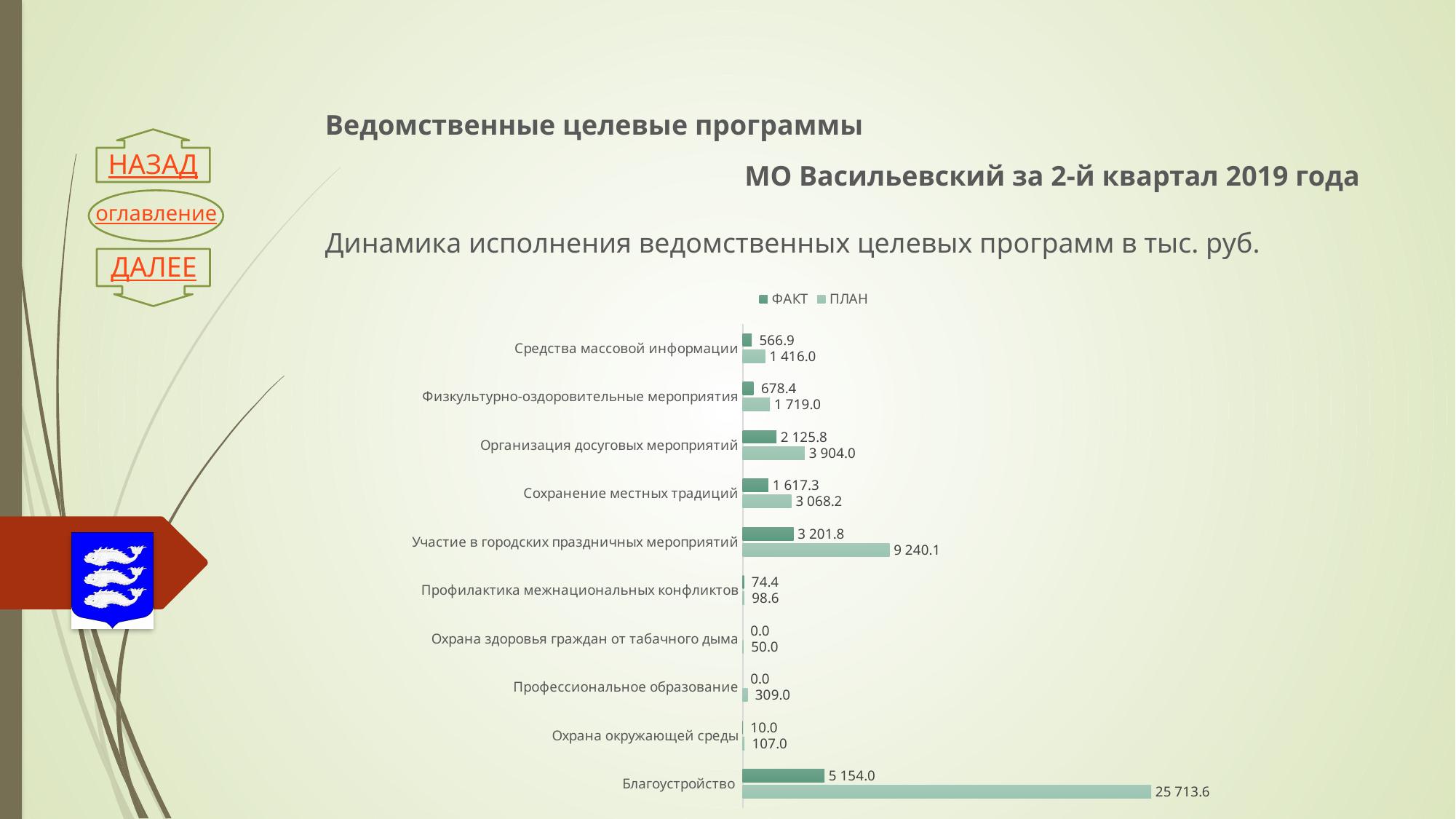
What is the ФАКТ value for Средства массовой информации? 566.9 What is the ПЛАН value for Участие в городских праздничных мероприятий? 9 240.1 How many series does the legend list? 2 Which category has the lowest ПЛАН value? Охрана здоровья граждан от табачного дыма What is the ФАКТ value for Благоустройство? 5 154.0 What are the two series named in the legend? ФАКТ and ПЛАН What kind of chart is shown on the slide? Bar chart What is the ПЛАН value for Профессиональное образование? 309.0 Which category has the highest ПЛАН value? Благоустройство What is the difference between the ПЛАН and ФАКТ values for Организация досуговых мероприятий? 1 778.2 Which is larger: the ФАКТ value for Сохранение местных традиций or the ФАКТ value for Физкультурно-оздоровительные мероприятия? Сохранение местных традиций How many categories are shown in the chart? 10